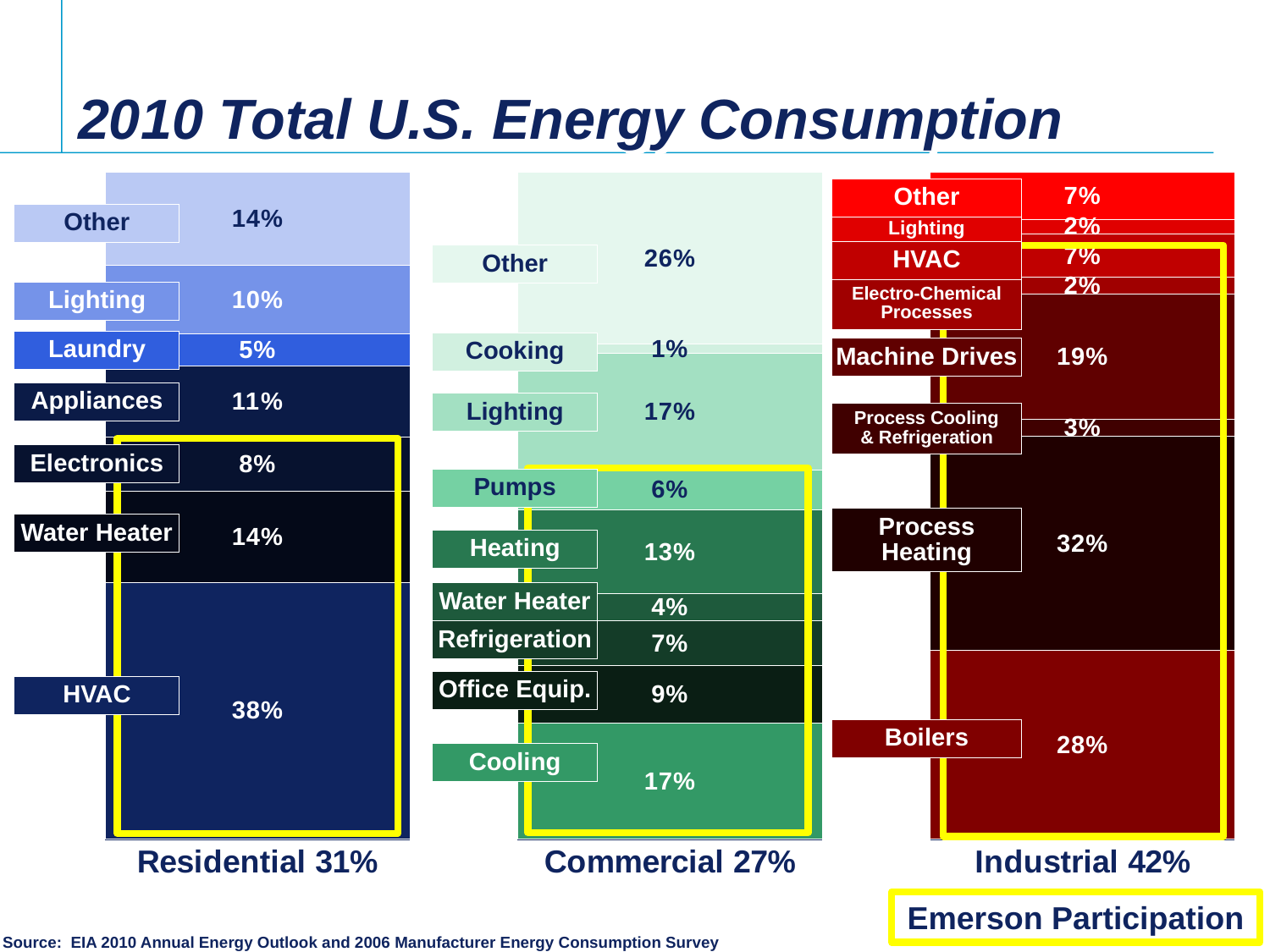
Which segment is the smallest in the Commercial bar? Cooking How many segments are in the Commercial bar? 9 Which segment is the largest in the Industrial bar? Process Heating In the Industrial bar, what share is Boilers? 28% In the Industrial bar, what share is Machine Drives? 19% In the Residential bar, what share is HVAC? 38% Which sector has the largest total share of 2010 U.S. energy consumption? Industrial 42% What kind of chart is shown on the slide? Stacked bar chart In the Commercial bar, what share is Office Equip.? 9% What is the difference between the Residential HVAC share and the Residential Water Heater share? 24% In the Commercial bar, which is larger: Heating or Pumps? Heating How many segments are in the Residential bar? 7